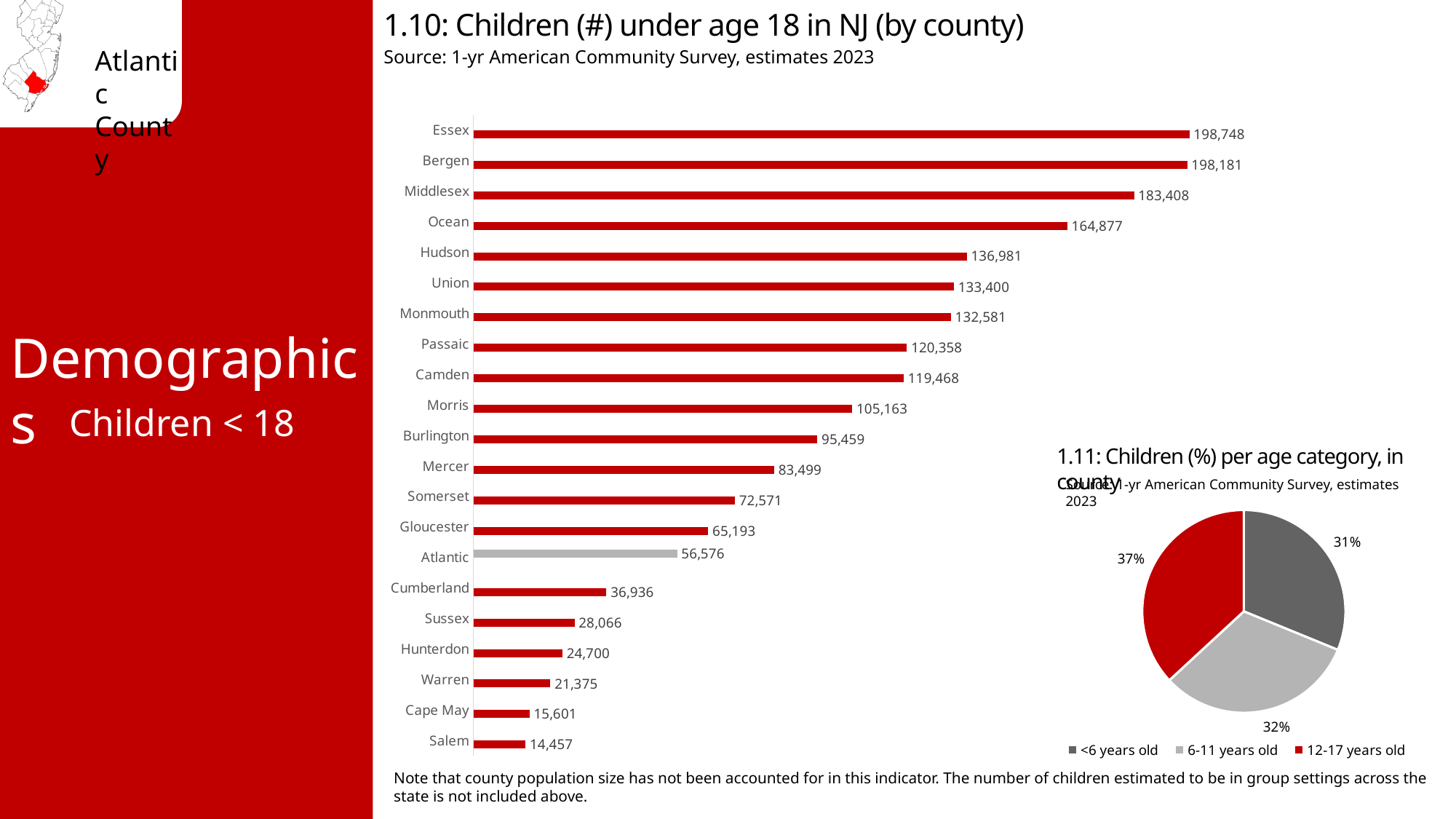
In chart 1.11, how many age categories does the legend list? 3 In chart 1.10, what is the difference between the values for Essex and Bergen? 567 In chart 1.10, which county has the highest number of children under age 18? Essex In chart 1.11, what percentage of children are 12-17 years old? 37% In chart 1.10, how many counties are shown? 21 In chart 1.10, what is the value for Ocean County? 164,877 In chart 1.10, what is the difference between the values for Atlantic and Cumberland? 19,640 What kind of chart is chart 1.10? Bar chart In chart 1.10, which county has the lowest number of children under age 18? Salem In chart 1.11, which age category has the smallest share? <6 years old In chart 1.10, how many children under age 18 are in Atlantic County? 56,576 In chart 1.10, which county has more children under 18, Passaic or Camden? Passaic